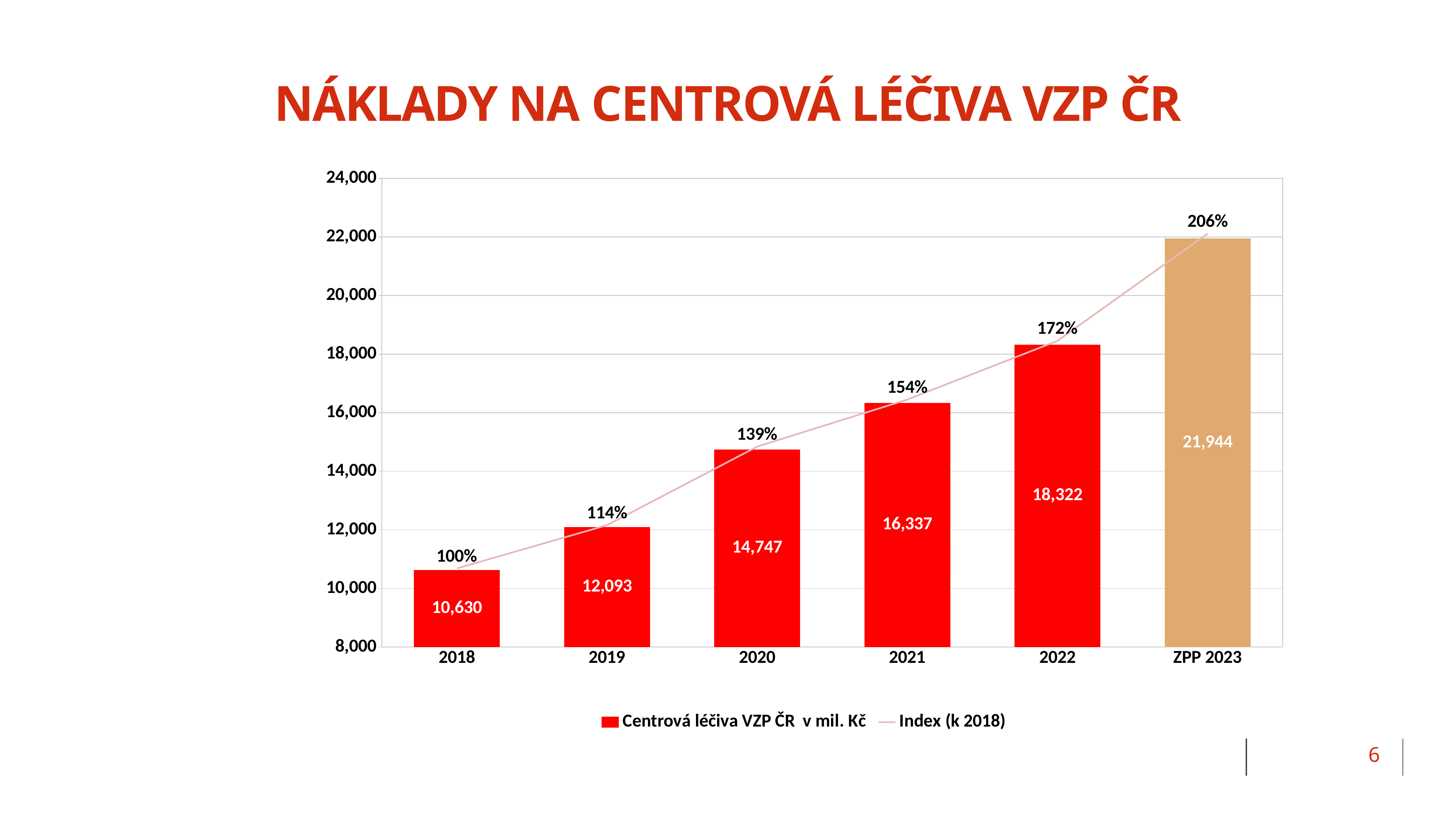
Which is larger, the Centrová léčiva VZP ČR v mil. Kč value for 2019 or for 2020? 2020 How many series does the legend list? 2 Do the Centrová léčiva VZP ČR v mil. Kč values rise or fall from 2018 to ZPP 2023? rise What is the Index (k 2018) value for 2022? 172% What is the difference in Centrová léčiva VZP ČR v mil. Kč between 2022 and 2021? 1,985 What kind of chart is shown on the slide? Combined bar and line chart What is the value of Centrová léčiva VZP ČR v mil. Kč for ZPP 2023? 21,944 Is the Centrová léčiva VZP ČR v mil. Kč value for 2021 greater or less than 16,000? greater Which category has the lowest value for Centrová léčiva VZP ČR v mil. Kč? 2018 Which category has the highest value for Centrová léčiva VZP ČR v mil. Kč? ZPP 2023 What is the value of Centrová léčiva VZP ČR v mil. Kč for 2020? 14,747 How many categories are shown on the x axis? 6